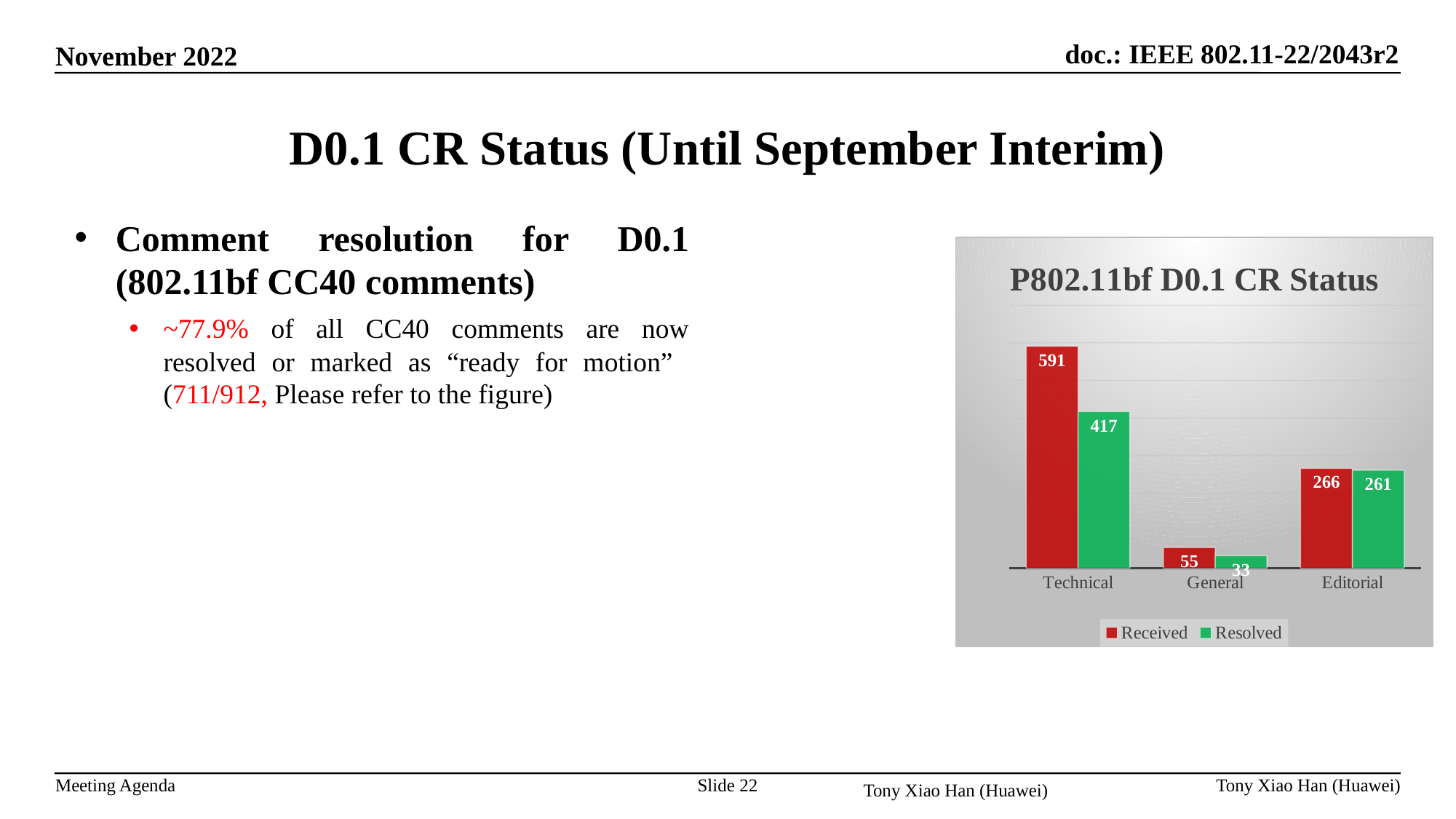
What is the Resolved value for General? 33 What is the difference between Received and Resolved for Technical? 174 Which category has the highest Received value? Technical What kind of chart is shown? Bar chart What is the difference between Received and Resolved for General? 22 What is the Received value for Technical? 591 What is the Resolved value for Editorial? 261 Which category has the lowest Resolved value? General Which is larger, the Resolved value for Technical or the Received value for Editorial? Resolved value for Technical What is the title of the chart? P802.11bf D0.1 CR Status How many categories are shown on the x axis? 3 How many series does the legend list? 2